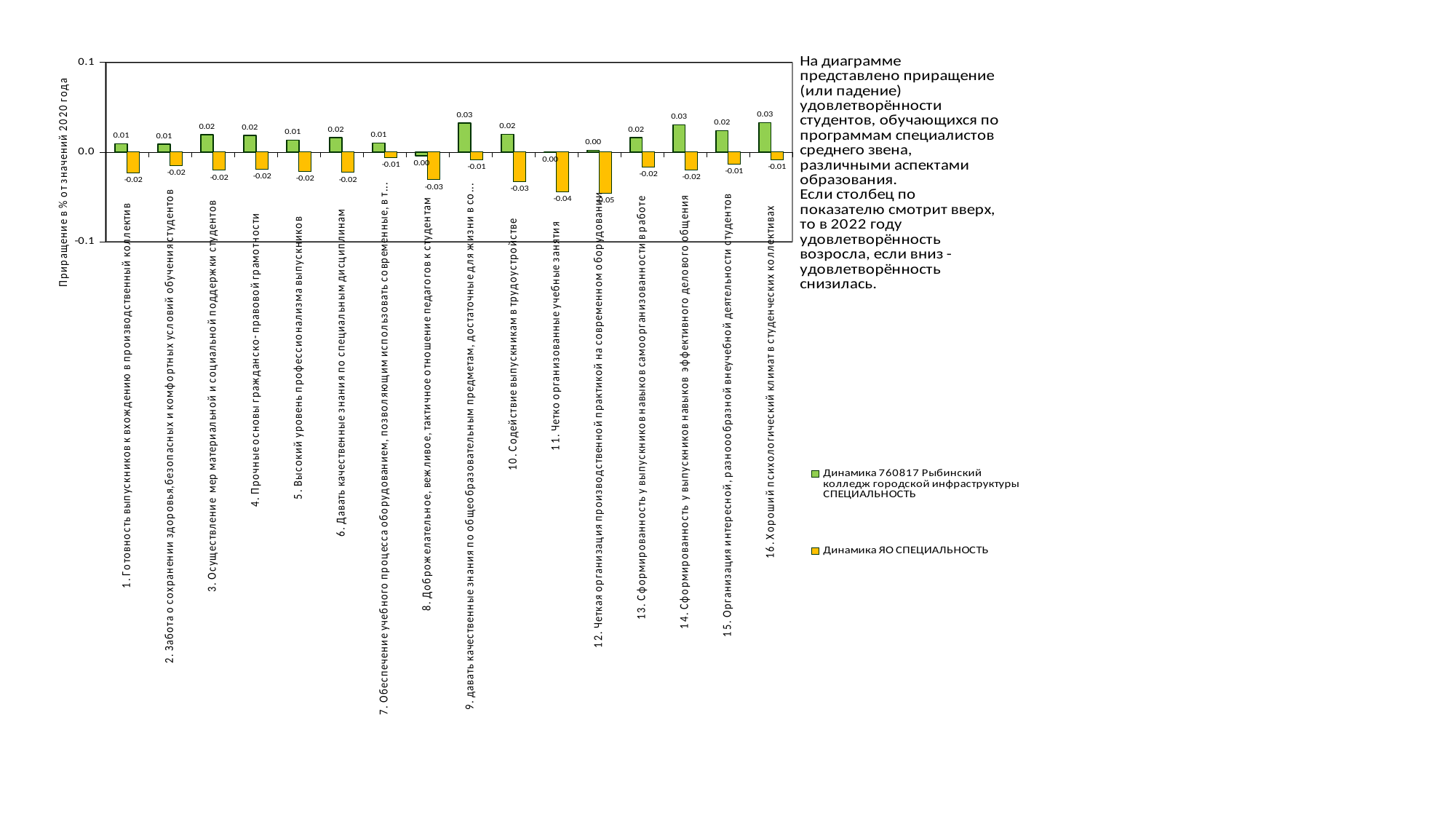
What is the value of the 'Динамика 760817 Рыбинский колледж городской инфраструктуры СПЕЦИАЛЬНОСТЬ' series for category 1 (Готовность выпускников к вхождению в производственный коллектив)? 0.01 What is the value of the 'Динамика 760817 Рыбинский колледж городской инфраструктуры СПЕЦИАЛЬНОСТЬ' series for category 9 (давать качественные знания по общеобразовательным предметам)? 0.03 What is the difference between the 'Динамика 760817 Рыбинский колледж' value and the 'Динамика ЯО' value for category 12? 0.05 What is the title of the vertical axis? Приращение в % от значений 2020 года What kind of chart is shown on the slide? Bar chart How many categories are plotted along the x axis? 16 For category 10 (Содействие выпускникам в трудоустройстве), which series has the larger value: 'Динамика 760817 Рыбинский колледж' or 'Динамика ЯО'? Динамика 760817 Рыбинский колледж городской инфраструктуры СПЕЦИАЛЬНОСТЬ How many series does the legend list? 2 For which category is the 'Динамика ЯО СПЕЦИАЛЬНОСТЬ' value the lowest? 12. Четкая организация производственной практикой на современном оборудовании What is the value of the 'Динамика ЯО СПЕЦИАЛЬНОСТЬ' series for category 11 (Четко организованные учебные занятия)? -0.04 What is the value of the 'Динамика ЯО СПЕЦИАЛЬНОСТЬ' series for category 12 (Четкая организация производственной практикой на современном оборудовании)? -0.05 Which colour represents the 'Динамика ЯО СПЕЦИАЛЬНОСТЬ' series? Yellow